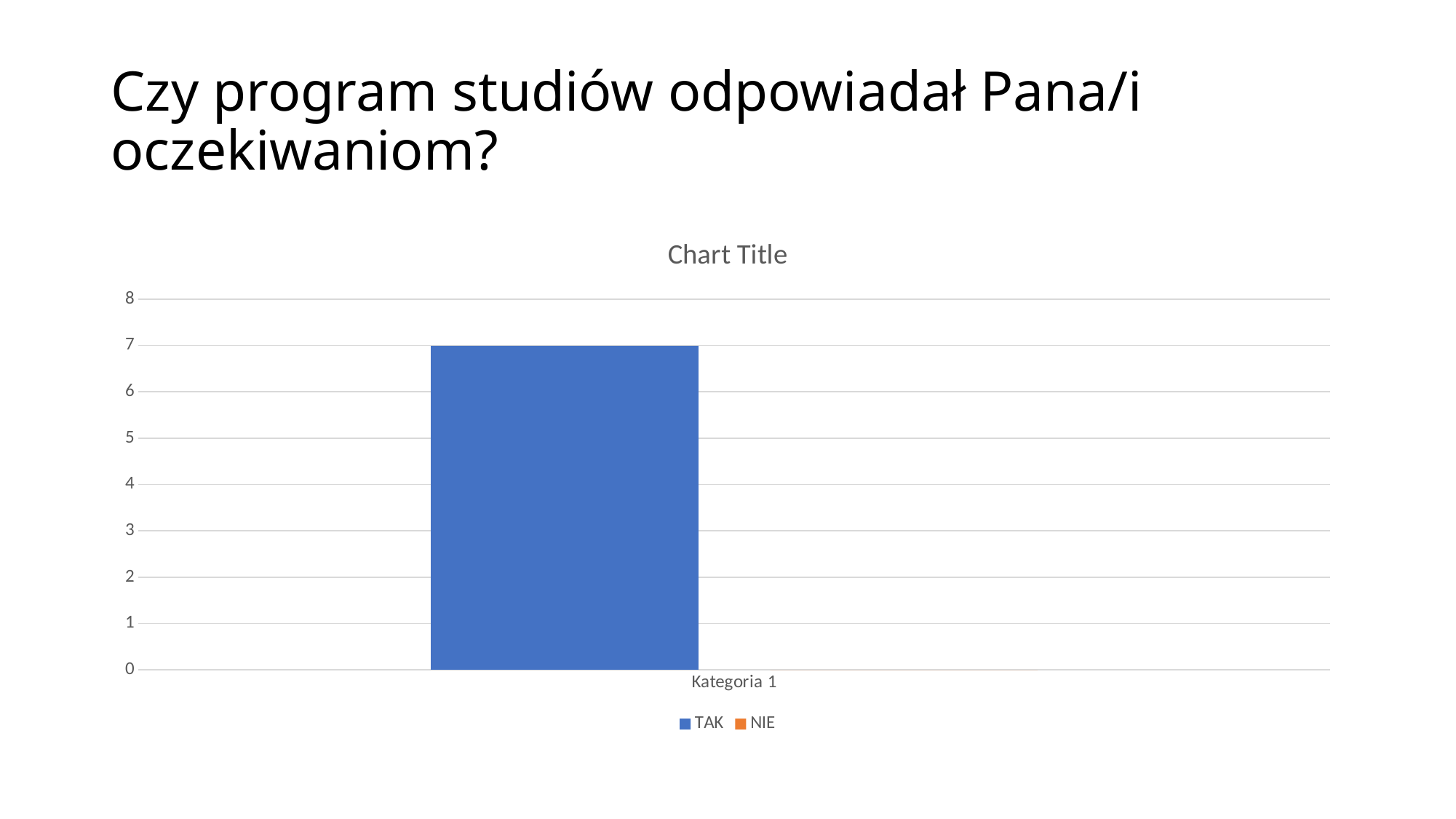
Which is larger, the value for TAK or the value for NIE? TAK What colour represents the TAK series in the legend? blue Is the value for TAK greater or less than 5? greater What kind of chart is shown on the slide? bar chart Which series has the lowest value? NIE Which series has the highest value? TAK What is the difference between the value for TAK and the value for NIE? 7 What is the title shown above the chart? Chart Title How many series does the legend list? 2 How many categories are shown on the x axis? 1 What is the value for NIE in Kategoria 1? 0 What is the value for TAK in Kategoria 1? 7